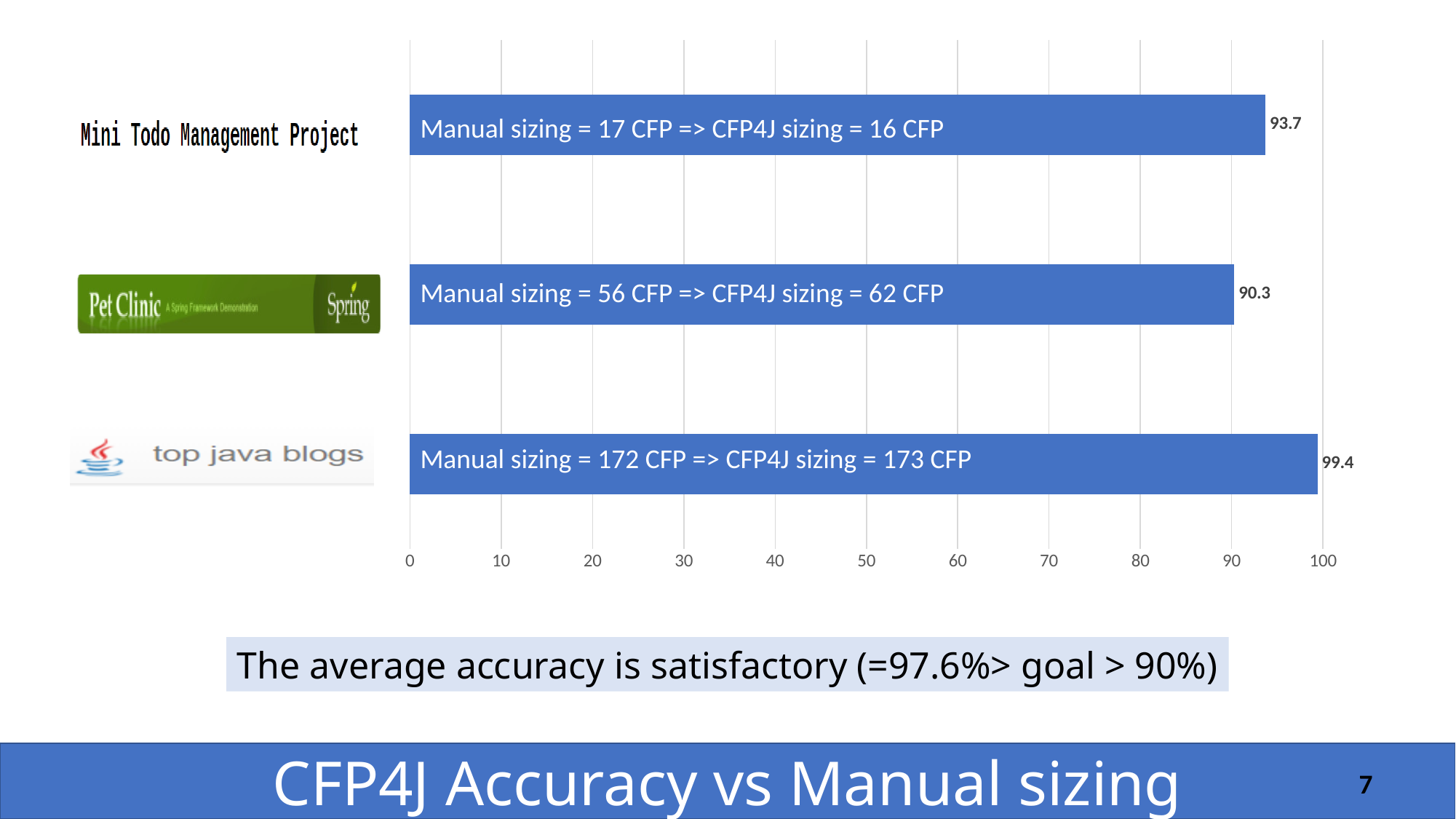
Which has a larger accuracy value, Mini Todo Management Project or top java blogs? top java blogs How many projects (bars) are shown in the chart? 3 What kind of chart is shown on the slide? bar chart According to the label on the top java blogs bar, what is the manual sizing in CFP? 172 CFP Which project has the lowest accuracy value in the chart? Pet Clinic What is the accuracy value shown for the top java blogs bar? 99.4 What is the accuracy value shown for the Pet Clinic bar? 90.3 What is the difference between the accuracy values for Mini Todo Management Project and Pet Clinic? 3.4 What is the difference between the accuracy values for top java blogs and Pet Clinic? 9.1 What is the accuracy value shown for the Mini Todo Management Project bar? 93.7 According to the label on the Pet Clinic bar, what is the CFP4J sizing in CFP? 62 CFP Which project has the highest accuracy value in the chart? top java blogs